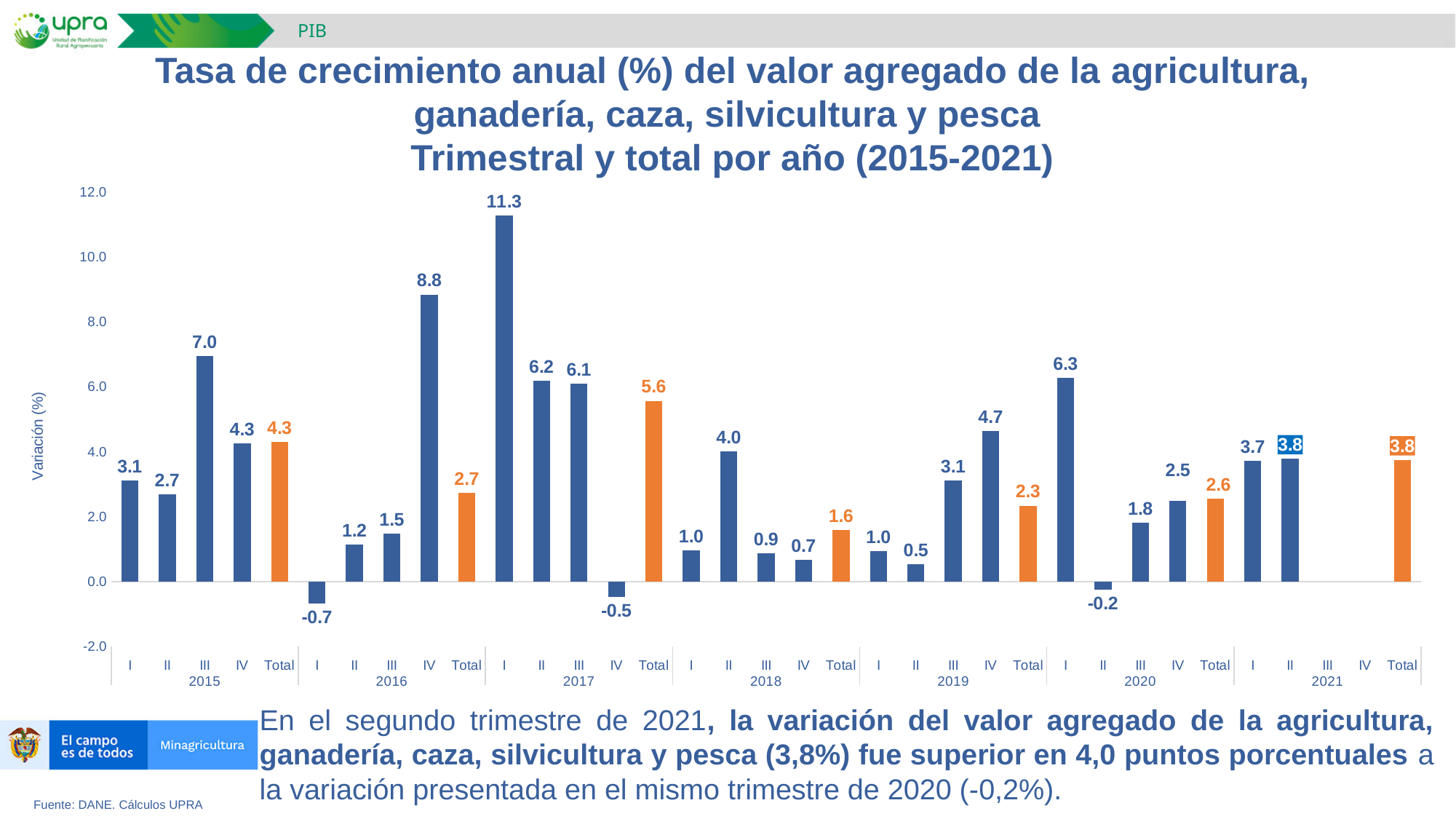
What is the annual total (Total) value shown for 2017? 5.6 Which quarter-year bar has the highest value on the chart? I 2017 What is the annual growth rate shown for the first quarter (I) of 2017? 11.3 What colour are the bars for the annual 'Total' values? Orange What is the value shown for the second quarter (II) of 2020? -0.2 What is the difference between the annual totals for 2017 and 2018? 4.0 Which quarter-year bar has the lowest value on the chart? I 2016 Do the quarterly values rise or fall from quarter I to quarter IV of 2019? Rise What type of chart is shown on the slide? Bar chart Which is larger: the annual total for 2015 or the annual total for 2016? 2015 (4.3) What is the difference between the value for quarter II of 2021 and quarter II of 2020? 4.0 What is the value shown for the second quarter (II) of 2021? 3.8